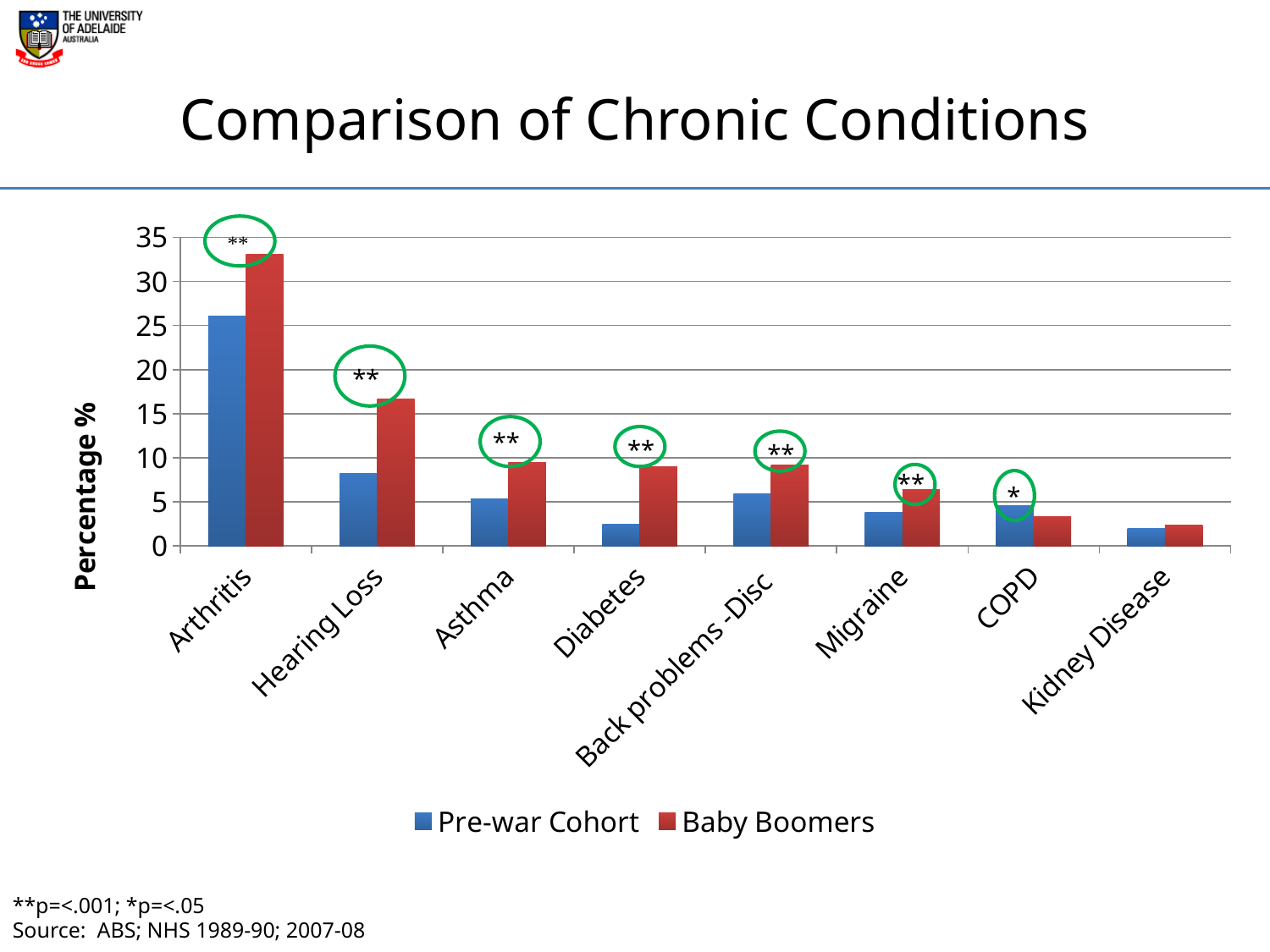
For Hearing Loss, which series has the larger value, Pre-war Cohort or Baby Boomers? Baby Boomers For COPD, which series has the larger value, Pre-war Cohort or Baby Boomers? Pre-war Cohort Is the Baby Boomers value for Hearing Loss greater or less than 15? greater Is the Baby Boomers value for Arthritis greater or less than 30? greater What is the title of the y axis? Percentage % Which condition has the highest value for the Pre-war Cohort? Arthritis What kind of chart is shown on the slide? bar chart Which condition has the highest value for Baby Boomers? Arthritis Is the Pre-war Cohort value for Diabetes greater or less than 5? less How many series does the legend list? 2 How many chronic conditions are shown on the x axis? 8 Which condition has the lowest value for Baby Boomers? Kidney Disease